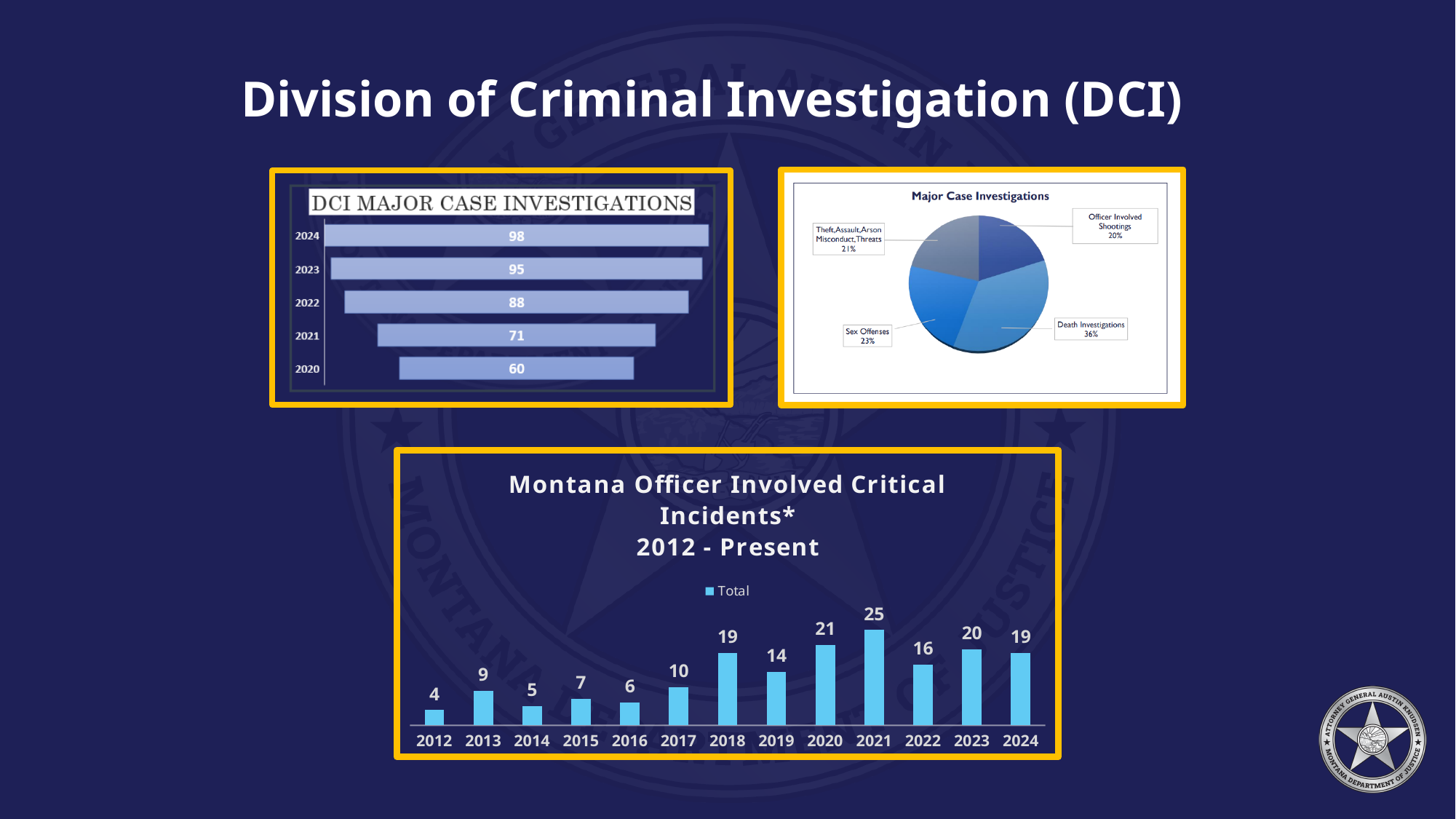
In the Major Case Investigations pie chart, what share is Sex Offenses? 23% In the DCI Major Case Investigations bar chart, what is the difference between the 2024 and 2020 values? 38 In the Major Case Investigations pie chart, which category has the smallest share? Officer Involved Shootings In the DCI Major Case Investigations bar chart, which year has the lowest value? 2020 What kind of chart is the Major Case Investigations chart on the right? Pie chart In the DCI Major Case Investigations bar chart, what is the value for 2024? 98 In the Montana Officer Involved Critical Incidents chart, what is the value for 2018? 19 In the Montana Officer Involved Critical Incidents chart, which year has the highest value? 2021 In the Major Case Investigations pie chart, what share is Death Investigations? 36% In the Montana Officer Involved Critical Incidents chart, which is larger, the value for 2020 or the value for 2022? 2020 In the DCI Major Case Investigations bar chart, how many years are shown? 5 In the Montana Officer Involved Critical Incidents chart, how many series does the legend list? 1